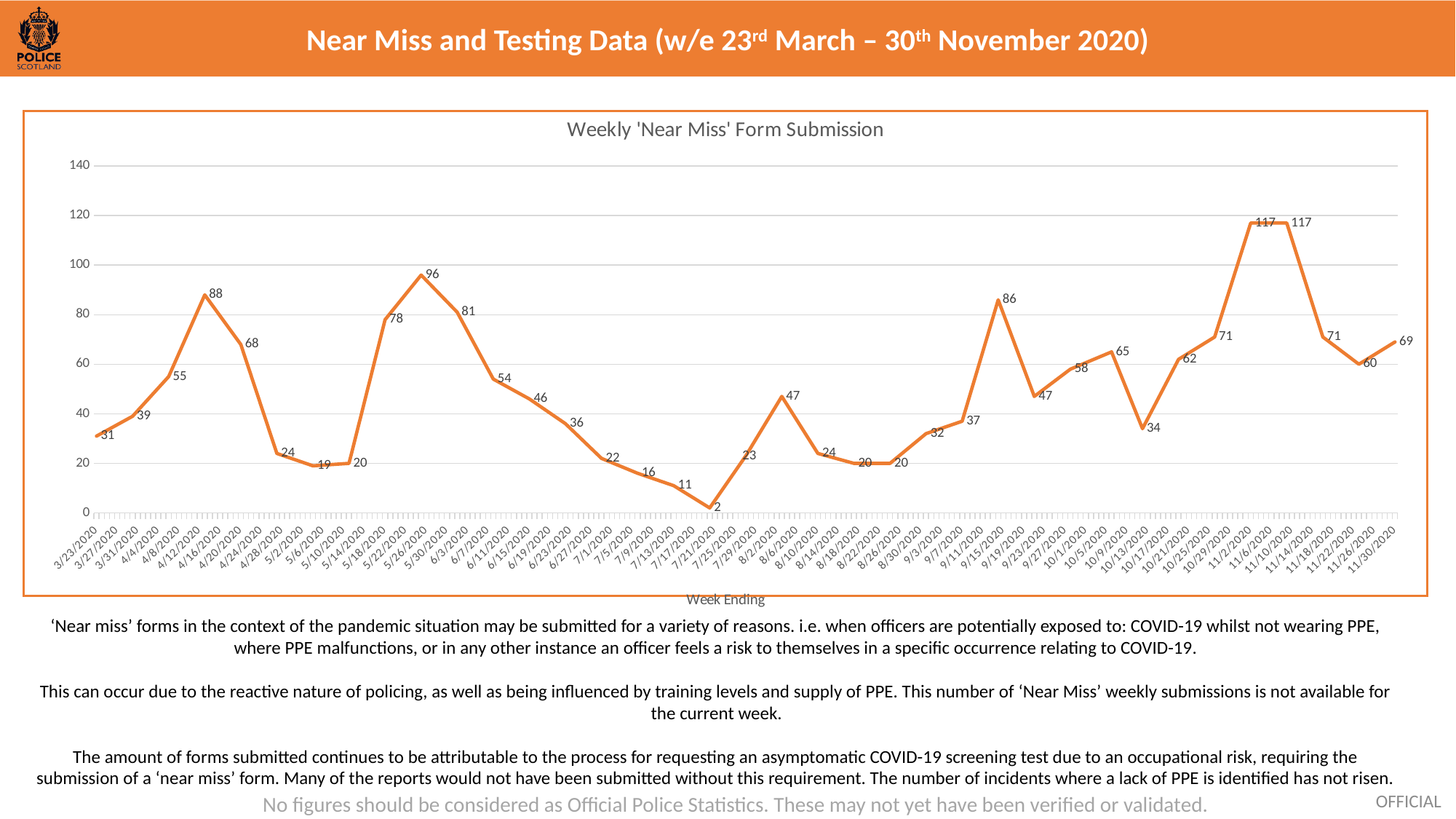
What is the highest value plotted on the chart? 117 What is the label on the x axis of the chart? Week Ending What kind of chart is shown on the slide? line chart Is the highest value on the chart greater or less than 100? greater What is the title of the chart? Weekly 'Near Miss' Form Submission Do the values rise or fall over the first four points of the line, from 31 to 88? rise Which is larger, the value for 3/23/2020 or the value for 11/30/2020? 11/30/2020 What is the value for the first week, 3/23/2020? 31 What is the value for the last week, 11/30/2020? 69 What is the lowest value plotted on the chart? 2 What is the difference between the highest value (117) and the lowest value (2) on the chart? 115 How many data points are plotted on the line? 37